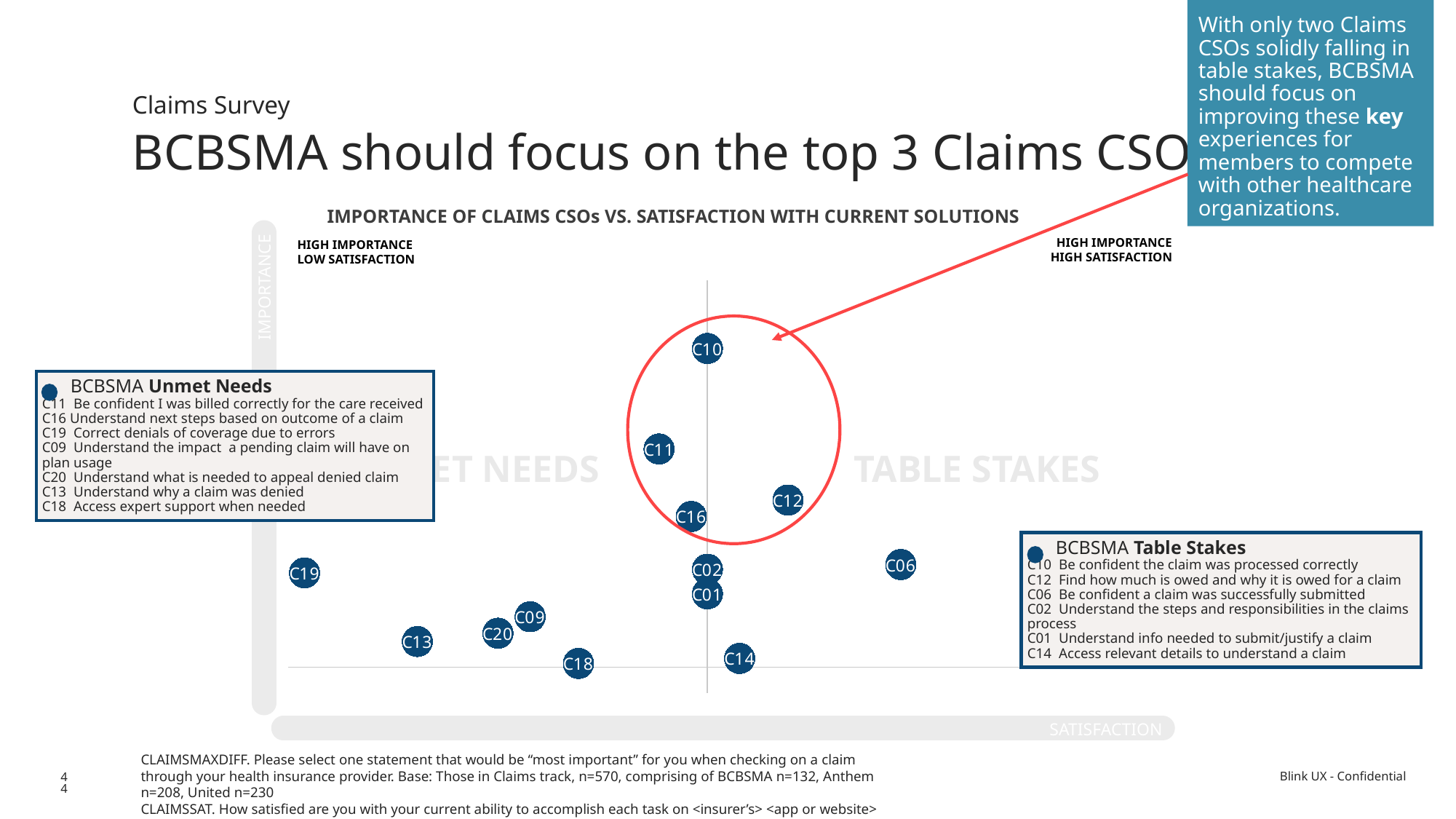
How many data points are enclosed by the red circle on the chart? 4 Which has higher importance on the chart, C11 or C18? C11 What is the title of the chart? IMPORTANCE OF CLAIMS CSOs VS. SATISFACTION WITH CURRENT SOLUTIONS How many labeled data points are plotted on the chart? 13 Which data point is in the upper-right quadrant labeled HIGH IMPORTANCE / HIGH SATISFACTION and furthest to the right? C06 Which data point has the highest satisfaction (furthest right) on the chart? C06 Which data point has the lowest satisfaction (furthest left) on the chart? C19 What does the vertical axis of the chart represent? IMPORTANCE What kind of chart is shown on the slide? scatter chart Which has higher satisfaction on the chart, C06 or C13? C06 Which has higher importance on the chart, C10 or C19? C10 Which data point has the highest importance on the chart? C10